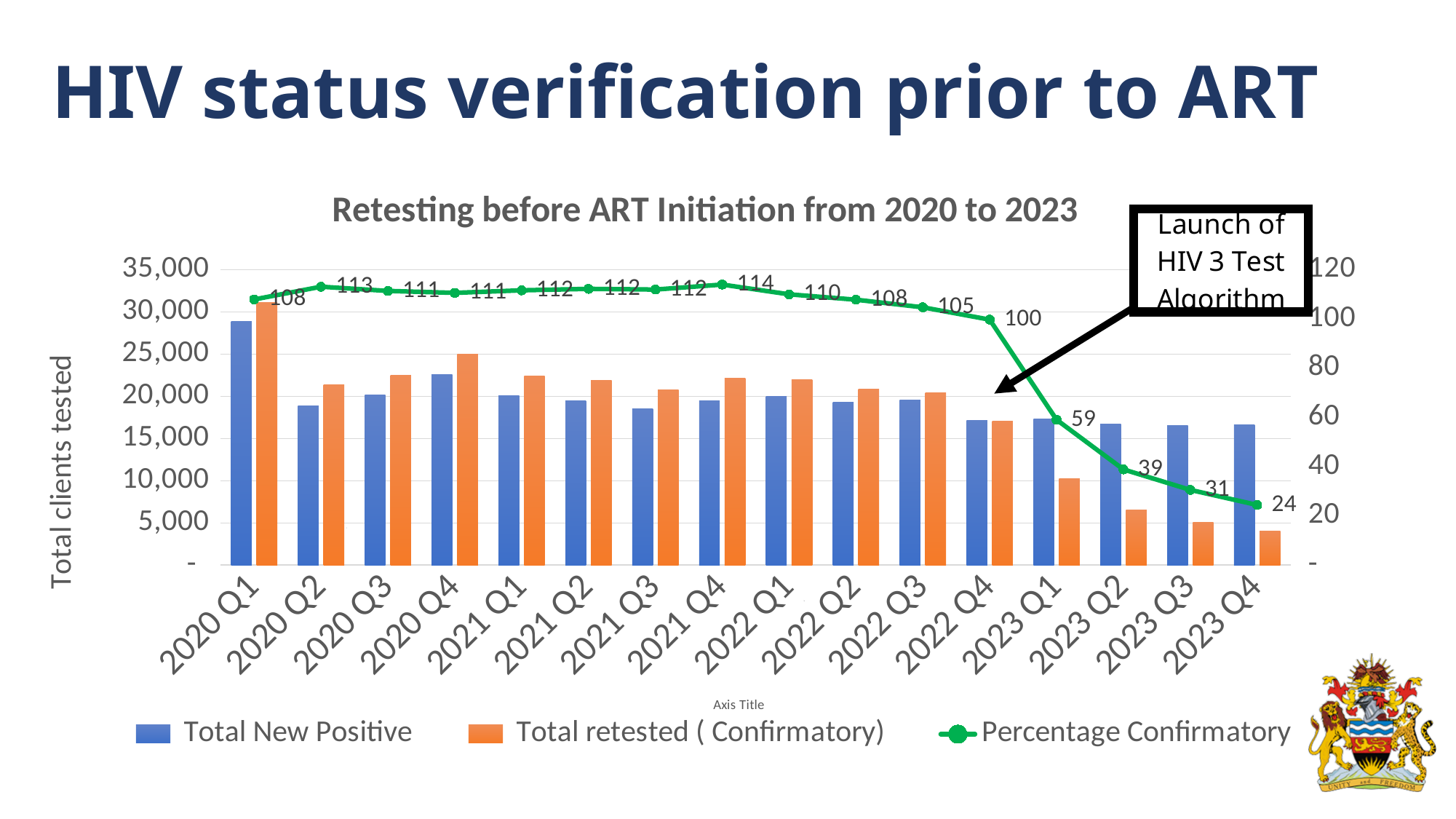
Which quarter has the lowest Percentage Confirmatory value? 2023 Q4 Which has a higher Percentage Confirmatory value, 2020 Q2 or 2022 Q1? 2020 Q2 What is the title of the chart? Retesting before ART Initiation from 2020 to 2023 Which quarter has the highest Percentage Confirmatory value? 2021 Q4 How many quarters are shown on the x axis of the chart? 16 Is the Total New Positive value for 2020 Q1 greater or less than 25,000? greater How many series does the chart legend list? 3 Does the Percentage Confirmatory line rise or fall from 2022 Q4 to 2023 Q4? fall What is the Percentage Confirmatory value for 2021 Q4? 114 Is the Total retested (Confirmatory) value for 2023 Q4 greater or less than 5,000? less What is the Percentage Confirmatory value for 2023 Q1? 59 What is the difference between the Percentage Confirmatory values for 2022 Q4 and 2023 Q1? 41